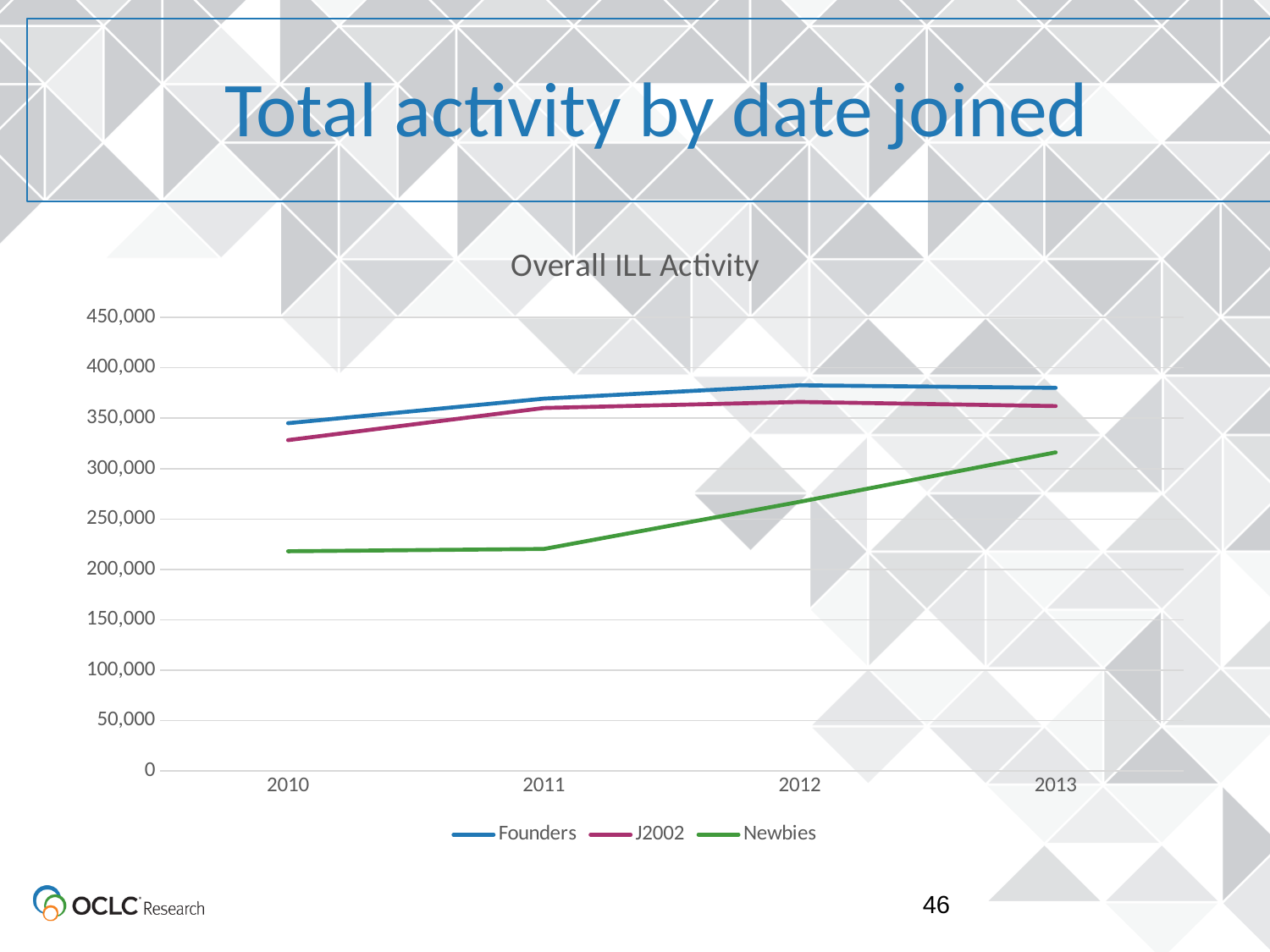
How many years are shown on the x axis? 4 Is the value for Newbies in 2010 greater or less than 250,000? less What kind of chart is shown on the slide? line chart How many series does the legend list? 3 Do the values for Newbies rise or fall from 2010 to 2013? rise Which is larger in 2013, the value for Founders or the value for Newbies? Founders What is the title of the chart? Overall ILL Activity Is the value for Newbies in 2013 greater or less than 300,000? greater Which series has the lowest value in 2010? Newbies Is the value for J2002 in 2010 greater or less than 350,000? less Which series has the highest value in 2013? Founders